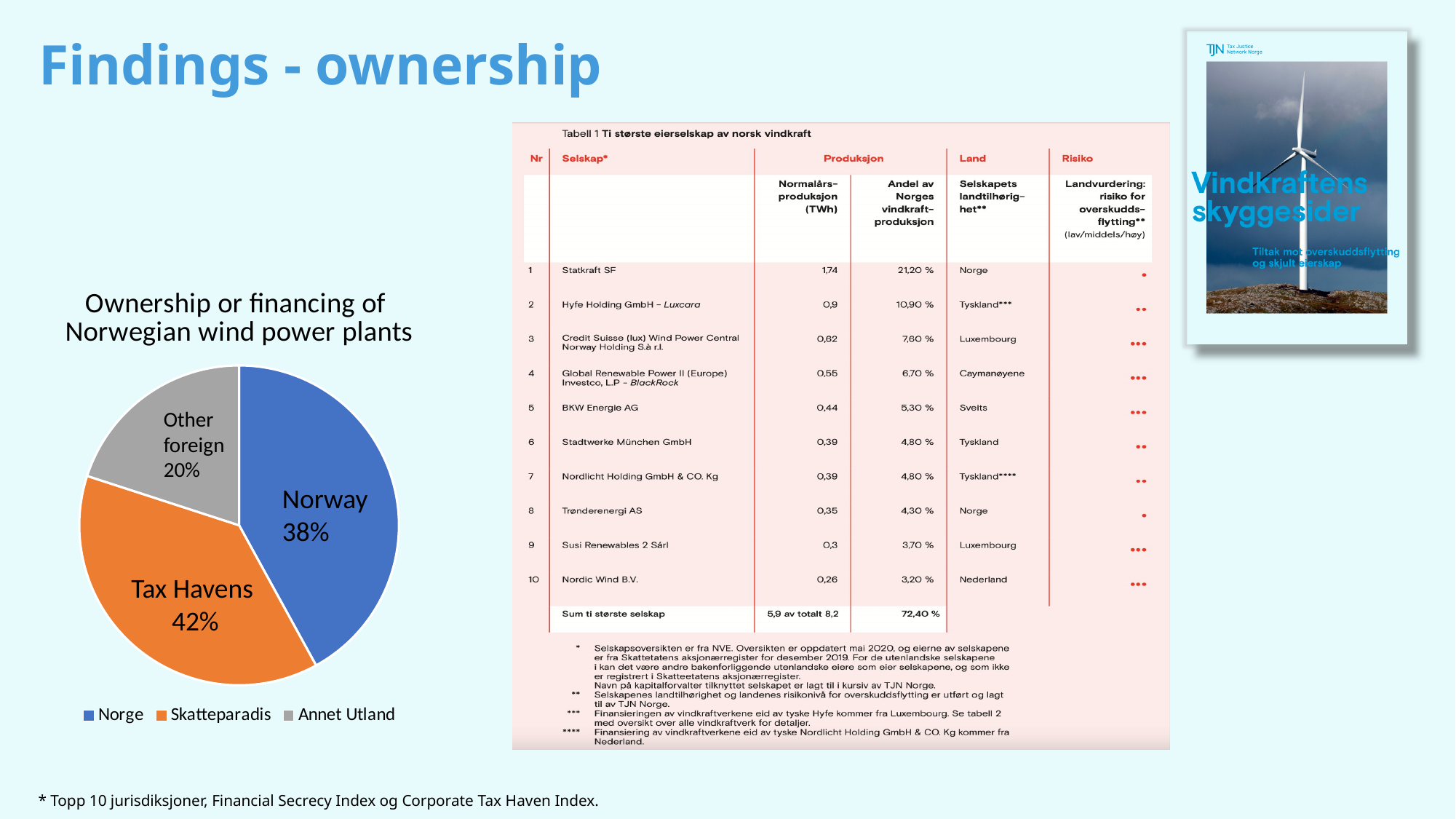
How many slices does the pie chart have? 3 Which is larger in the pie chart, the Norway slice or the Other foreign slice? Norway How many entries does the pie chart's legend list? 3 Which colour represents Skatteparadis in the pie chart's legend? orange What share of the pie chart is labelled Tax Havens? 42% Which slice of the pie chart is the smallest? Other foreign What is the difference in percentage points between the Tax Havens slice and the Norway slice? 4 What share of the pie chart is labelled Other foreign? 20% What kind of chart is shown on the slide? pie chart Which slice of the pie chart is the largest? Tax Havens What is the title of the pie chart? Ownership or financing of Norwegian wind power plants What share of the pie chart is labelled Norway? 38%